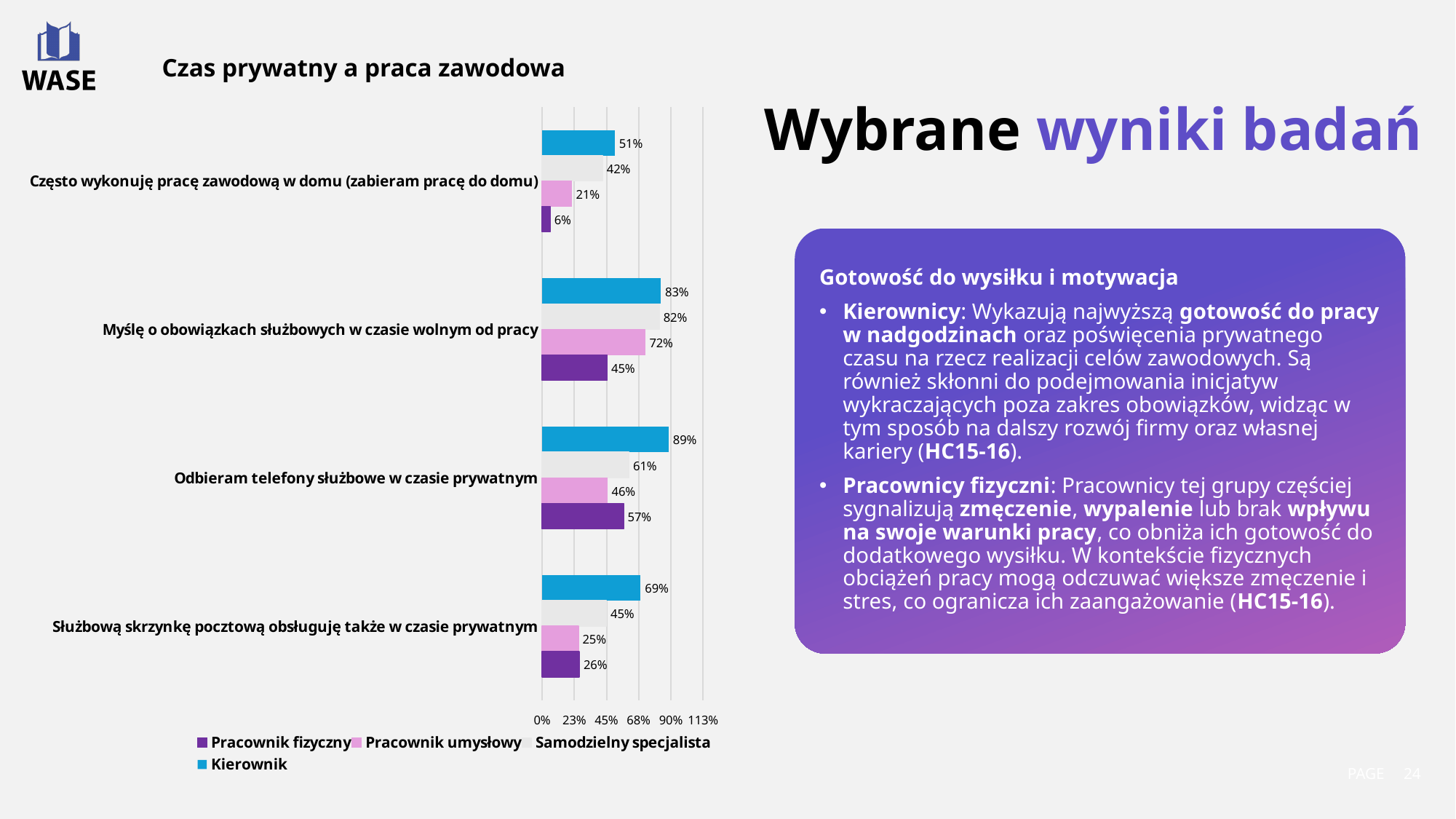
What is the title of the chart? Czas prywatny a praca zawodowa Which series has the highest value for 'Służbową skrzynkę pocztową obsługuję także w czasie prywatnym'? Kierownik What type of chart is shown on the slide? bar chart How many categories (statements) are shown on the chart? 4 For 'Odbieram telefony służbowe w czasie prywatnym', which is larger: the value for Samodzielny specjalista or for Pracownik fizyczny? Samodzielny specjalista Which series has the lowest value for 'Odbieram telefony służbowe w czasie prywatnym'? Pracownik umysłowy What is the value for Pracownik umysłowy for 'Służbową skrzynkę pocztową obsługuję także w czasie prywatnym'? 25% What is the value for Kierownik for 'Odbieram telefony służbowe w czasie prywatnym'? 89% How many series does the chart legend list? 4 What is the value for Samodzielny specjalista for 'Myślę o obowiązkach służbowych w czasie wolnym od pracy'? 82% What is the difference between the Kierownik and Pracownik fizyczny values for 'Myślę o obowiązkach służbowych w czasie wolnym od pracy'? 38% What is the value for Pracownik fizyczny for 'Często wykonuję pracę zawodową w domu (zabieram pracę do domu)'? 6%